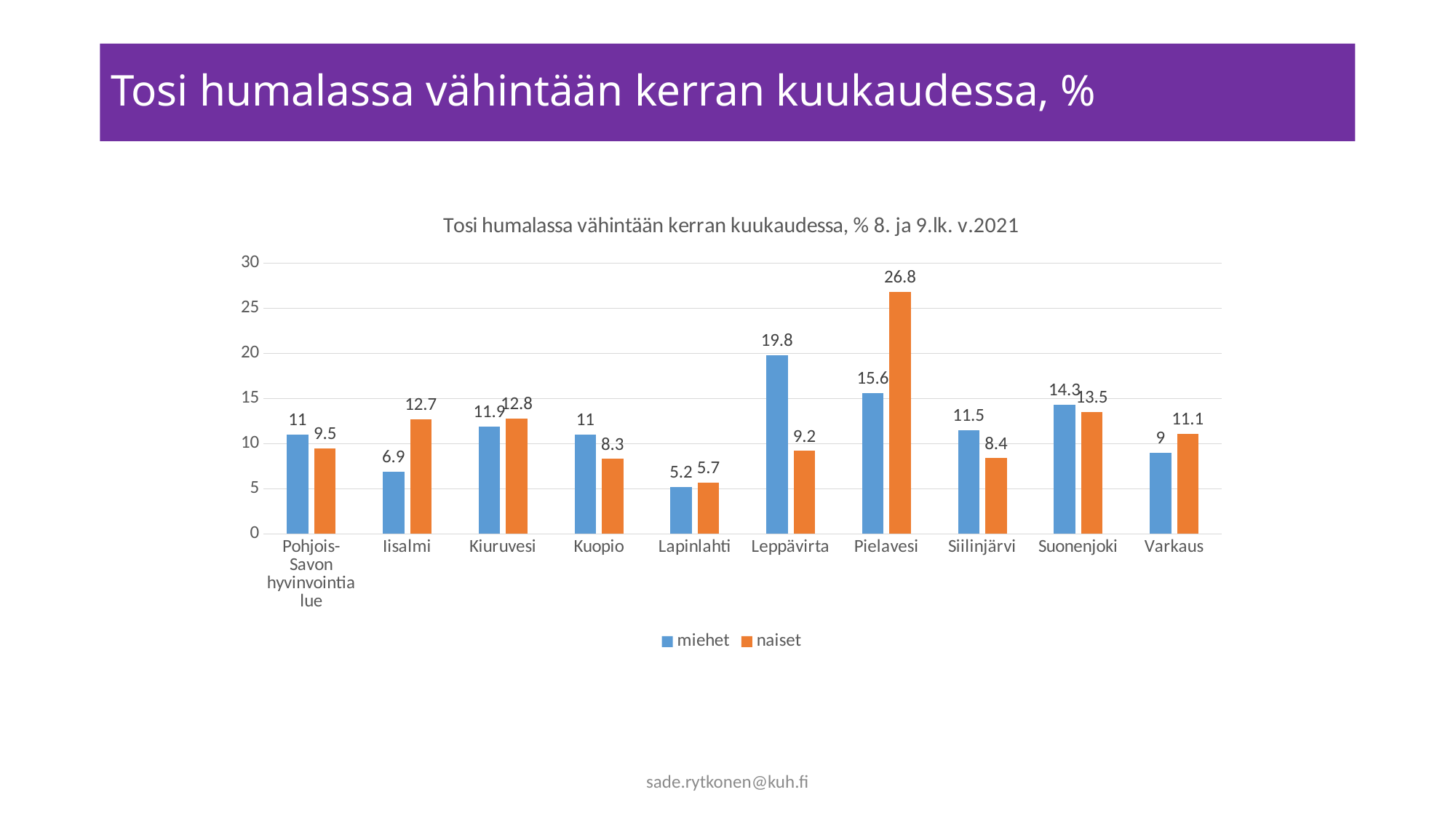
How many series does the legend list? 2 What is the value for naiset in Kuopio? 8.3 Which category has the lowest value for miehet? Lapinlahti Is the value for miehet in Leppävirta greater or less than 15? greater What is the value for miehet in Leppävirta? 19.8 How many categories are shown on the x axis? 10 Which is larger in Suonenjoki, the value for miehet or for naiset? miehet What kind of chart is shown on the slide? bar chart Which category has the highest value for naiset? Pielavesi What is the difference between the naiset and miehet values in Pielavesi? 11.2 What is the value for naiset in Pielavesi? 26.8 Which colour represents the naiset series? orange